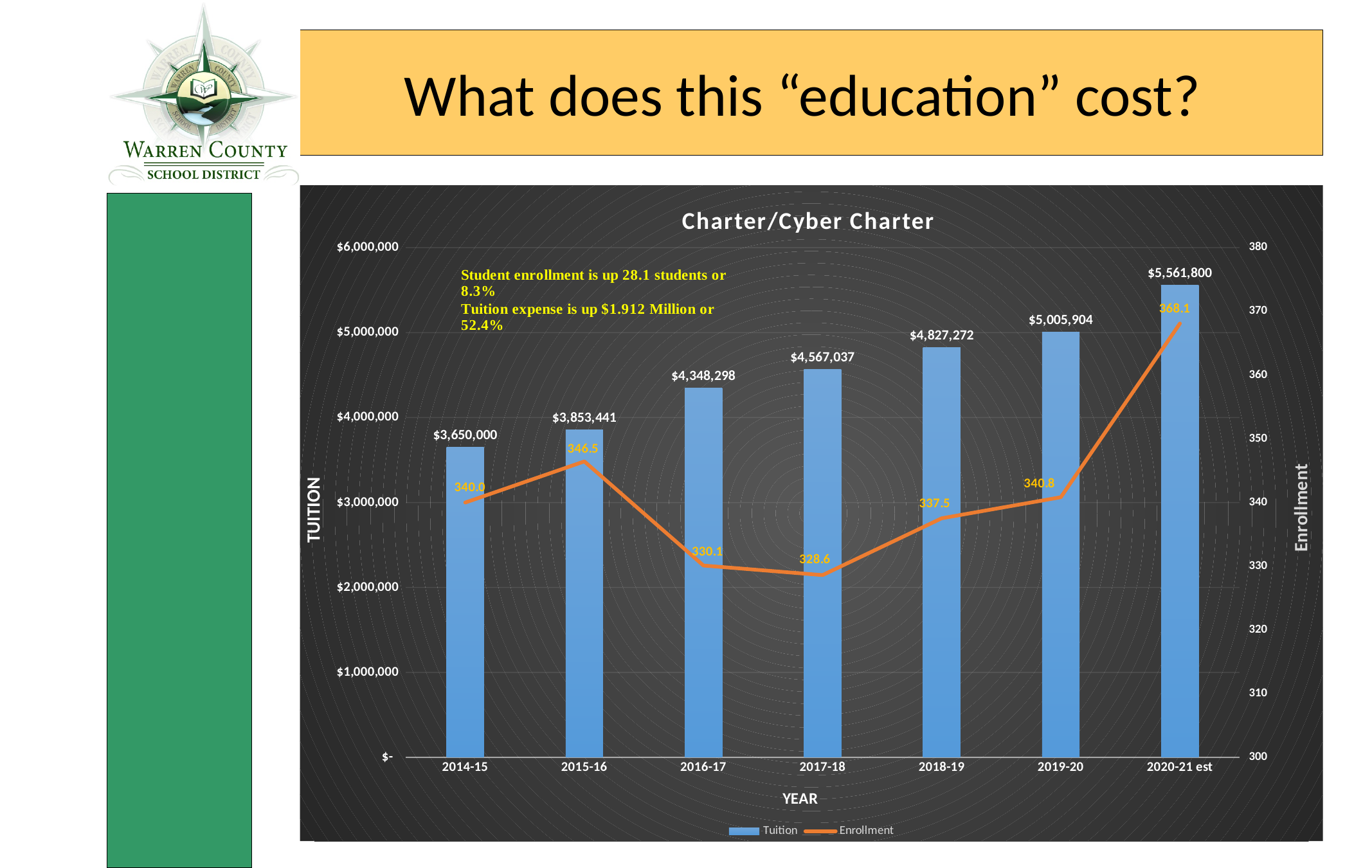
What is the Enrollment value for 2017-18? 328.6 What is the difference in Enrollment between 2020-21 est and 2014-15? 28.1 Which year has the larger Enrollment, 2015-16 or 2018-19? 2015-16 Which year has the lowest Tuition? 2014-15 How many series does the legend list? 2 What is the difference in Tuition between 2020-21 est and 2014-15? $1,911,800 Does the Tuition series rise or fall from 2014-15 to 2020-21 est? rise Which year has the highest Enrollment? 2020-21 est Which year has the lowest Enrollment? 2017-18 What is the Tuition value for 2016-17? $4,348,298 How many years are shown on the x axis? 7 What is the Tuition value for 2020-21 est? $5,561,800